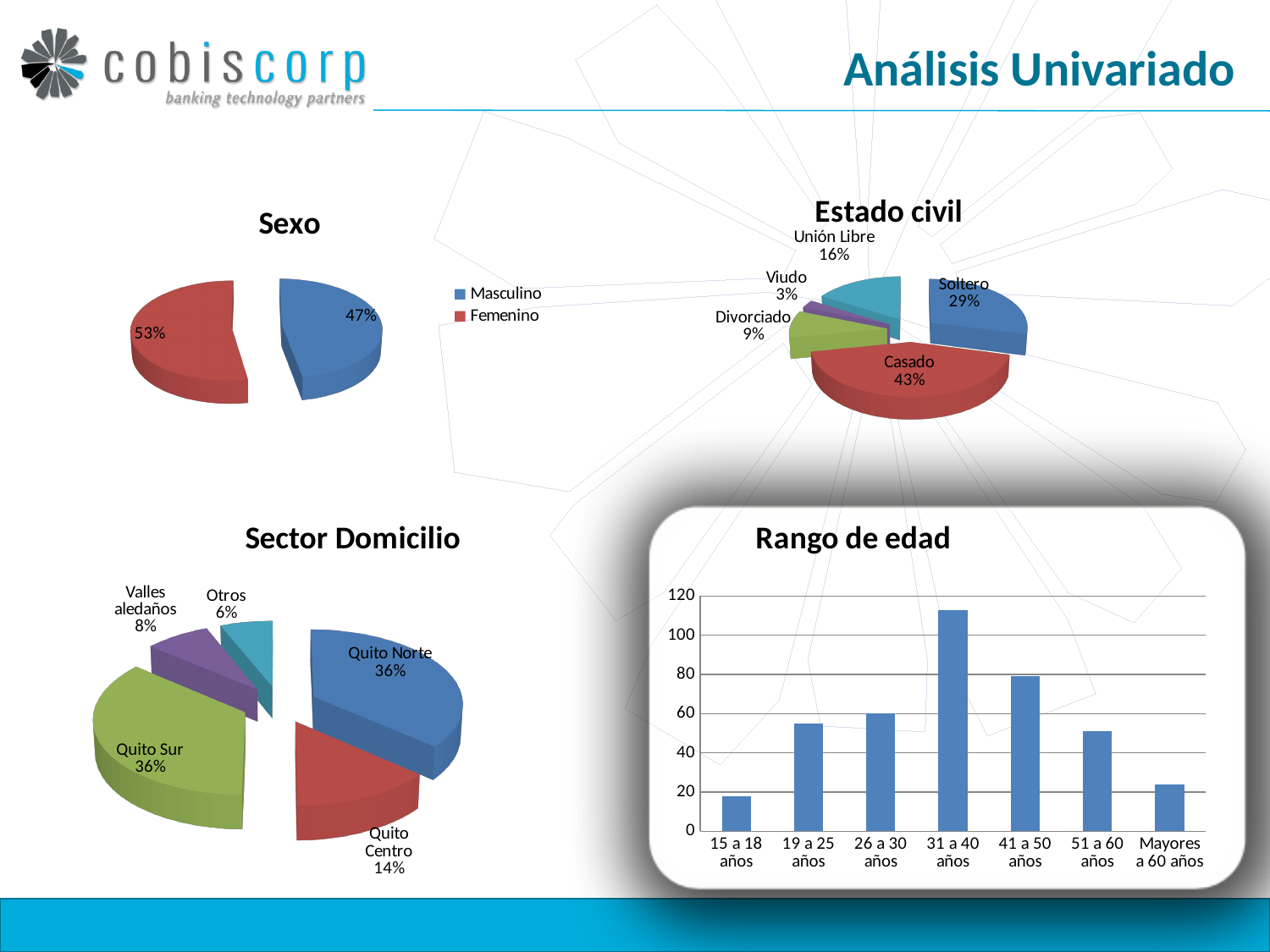
In the Estado civil chart, which category has the smallest share? Viudo In the Estado civil chart, what percentage is Casado? 43% In the Sexo chart, how many entries does the legend list? 2 In the Rango de edad chart, is the value for 31 a 40 años greater or less than 100? greater In the Rango de edad chart, which age range has the lowest value? 15 a 18 años In the Sector Domicilio chart, which category has the smallest share? Otros In the Sector Domicilio chart, what percentage is Quito Centro? 14% What kind of chart is Rango de edad? bar chart In the Sector Domicilio chart, how many categories are shown? 5 In the Sexo chart, what percentage is Femenino? 53% In the Rango de edad chart, which age range has the highest value? 31 a 40 años In the Estado civil chart, what is the difference between Soltero and Unión Libre? 13%